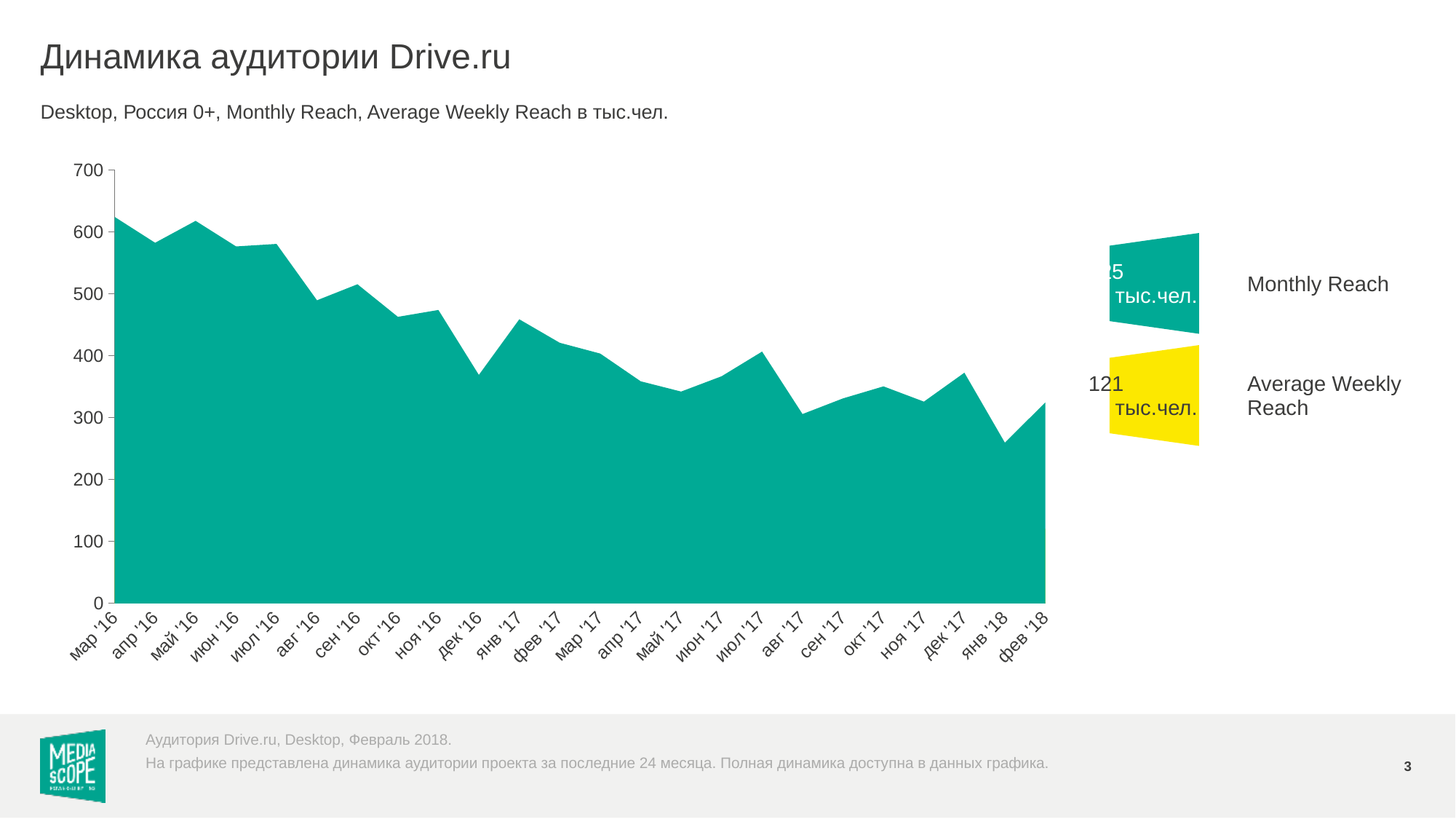
Which month has the highest Monthly Reach value on the chart? мар '16 Is the Monthly Reach value for мар '16 greater or less than 600? greater How many months are plotted along the x axis of the chart? 24 What kind of chart is shown on the slide? area chart Is the Monthly Reach value for янв '18 greater or less than 300? less Is the Monthly Reach value for дек '16 greater or less than 400? less What Average Weekly Reach value is shown in the yellow box next to the chart? 121 тыс.чел. Overall, do the Monthly Reach values rise or fall from мар '16 to фев '18? fall Which month has a larger Monthly Reach value, дек '16 or янв '17? янв '17 Which month has the lowest Monthly Reach value on the chart? янв '18 Which month has a larger Monthly Reach value, мар '16 or фев '18? мар '16